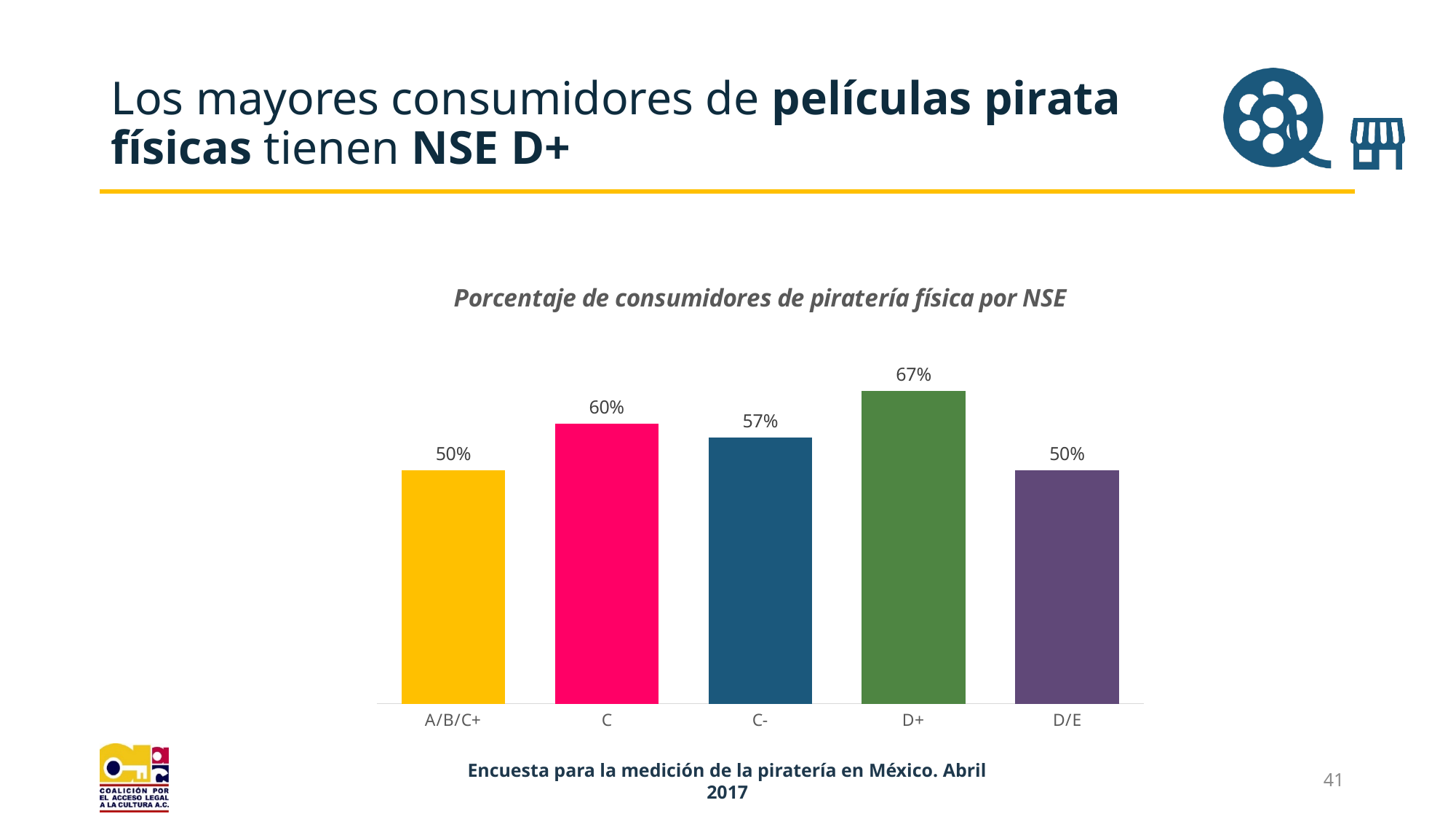
What kind of chart is shown on the slide? Bar chart How many NSE categories are shown in the chart? 5 What is the value for C-? 57% What is the difference between the values for C and A/B/C+? 10% Which NSE category has the highest percentage? D+ What is the value for C? 60% What is the title of the chart? Porcentaje de consumidores de piratería física por NSE What is the difference between the values for D+ and C-? 10% Which is larger, the value for D+ or the value for D/E? D+ Which is larger, the value for C or the value for C-? C What is the value for A/B/C+? 50% What is the value for D+? 67%